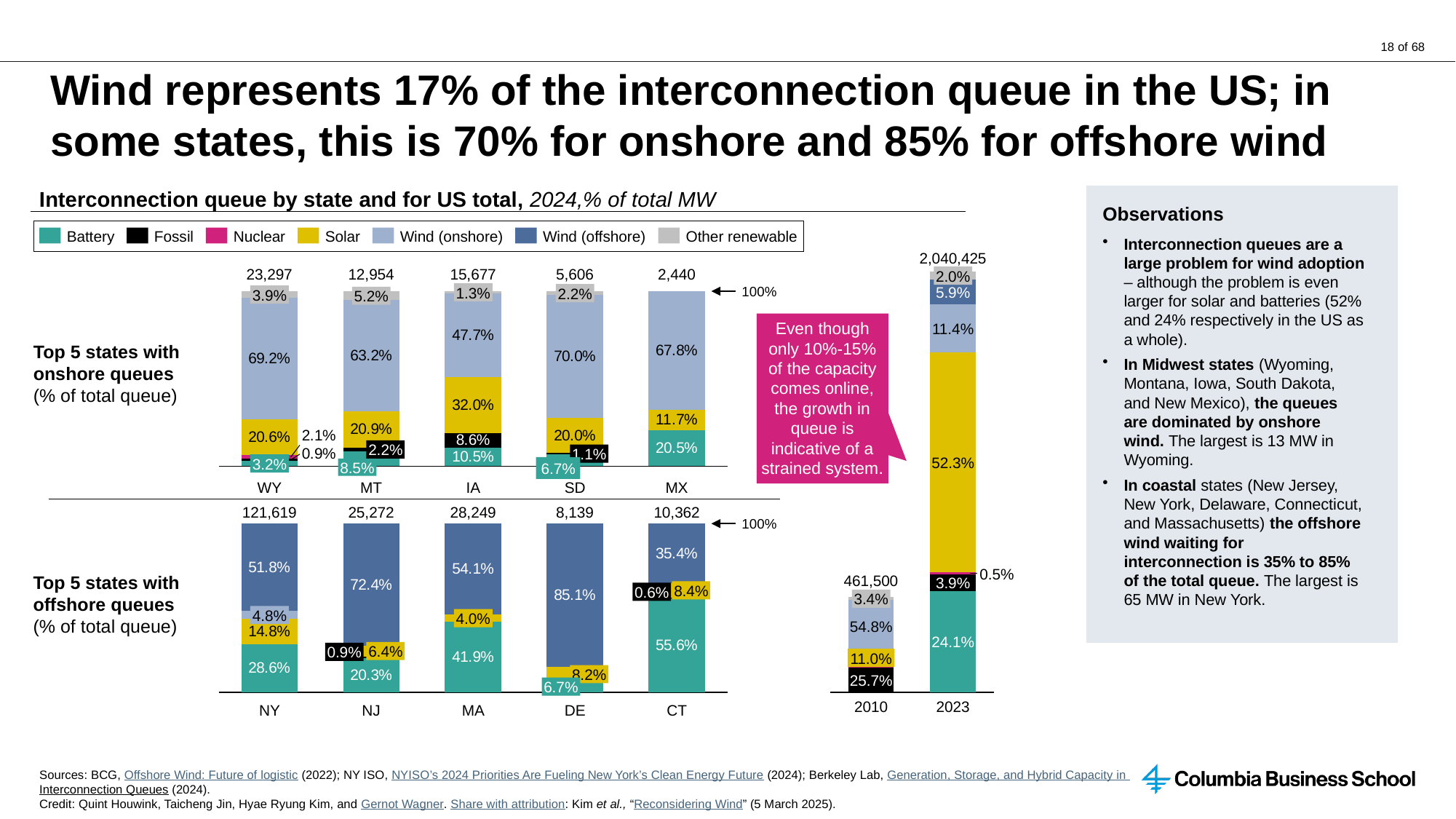
In the US total chart on the right, what is the Solar share in 2023? 52.3% In the top 5 states with offshore queues chart, which state has the highest Wind (offshore) share? DE In the top 5 states with offshore queues chart, what total MW value is printed above the NY bar? 121,619 In the top 5 states with onshore queues chart, what is the difference in Wind (onshore) share between WY and MT? 6.0 percentage points In the US total chart on the right, what is the Wind (onshore) share in 2010? 54.8% In the top 5 states with offshore queues chart, which has the larger Wind (offshore) share, NY or NJ? NJ In the top 5 states with offshore queues chart, what is the difference between the Battery share and the Wind (offshore) share for CT? 20.2 percentage points How many series does the legend list? 7 How many states are shown in the top 5 states with onshore queues chart? 5 What kind of chart is used to show the interconnection queue by state? Stacked bar chart In the top 5 states with onshore queues chart, what share of the queue is Wind (onshore) for SD? 70.0% In the top 5 states with onshore queues chart, which state has the lowest Wind (onshore) share? IA